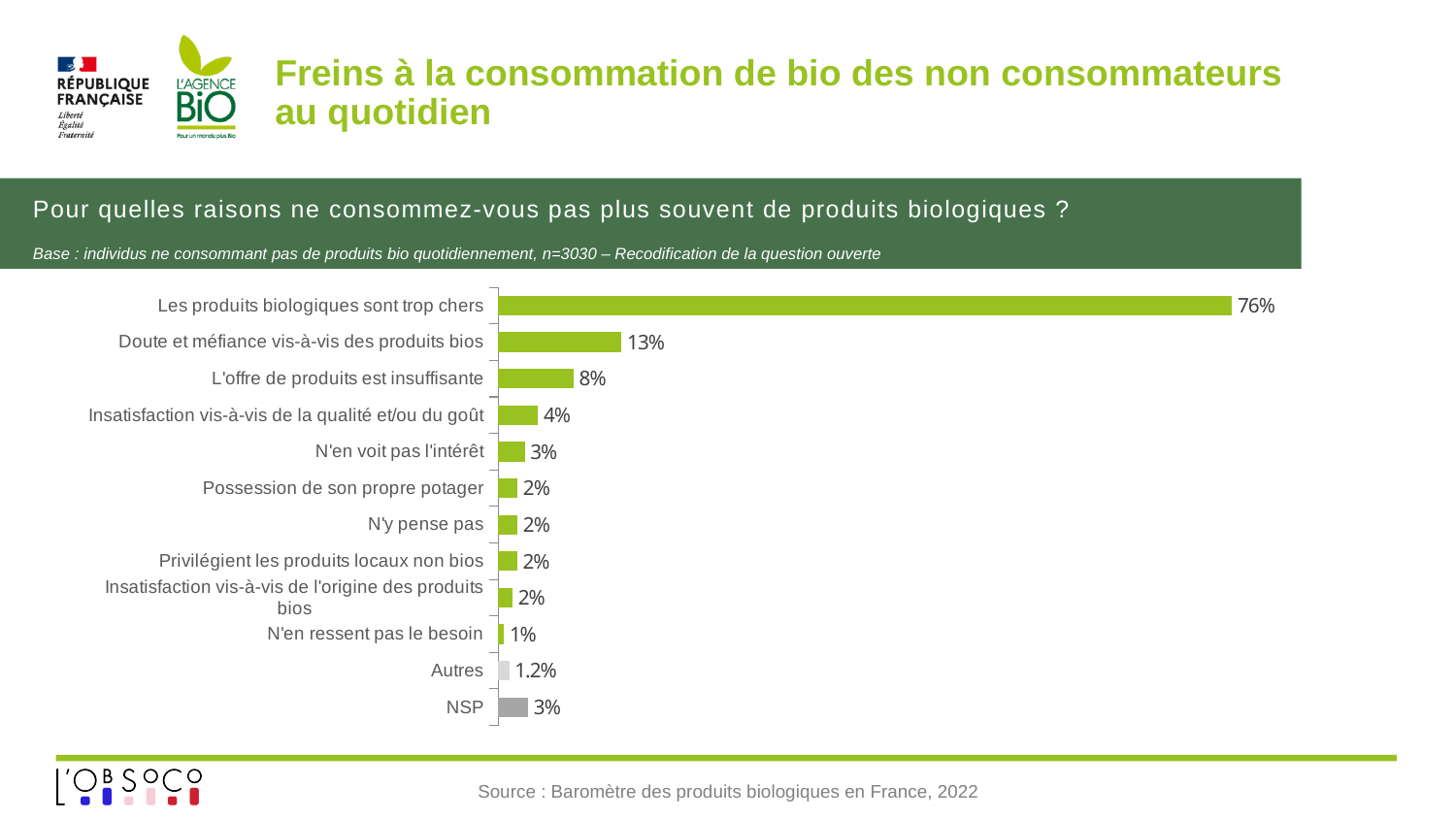
What is the value for "NSP"? 3% What is the sample size (n) stated in the base note above the chart? n=3030 What is the value for "L'offre de produits est insuffisante"? 8% What is the value for "Autres"? 1.2% Which is larger: "L'offre de produits est insuffisante" or "Insatisfaction vis-à-vis de la qualité et/ou du goût"? L'offre de produits est insuffisante Which category has the lowest percentage? N'en ressent pas le besoin How many categories are shown in the chart? 12 Which reason has the highest percentage? Les produits biologiques sont trop chers What is the difference between "Les produits biologiques sont trop chers" and "Doute et méfiance vis-à-vis des produits bios"? 63 percentage points What type of chart is shown on the slide? Bar chart What is the value for "Doute et méfiance vis-à-vis des produits bios"? 13% What percentage of respondents say organic products are too expensive ("Les produits biologiques sont trop chers")? 76%